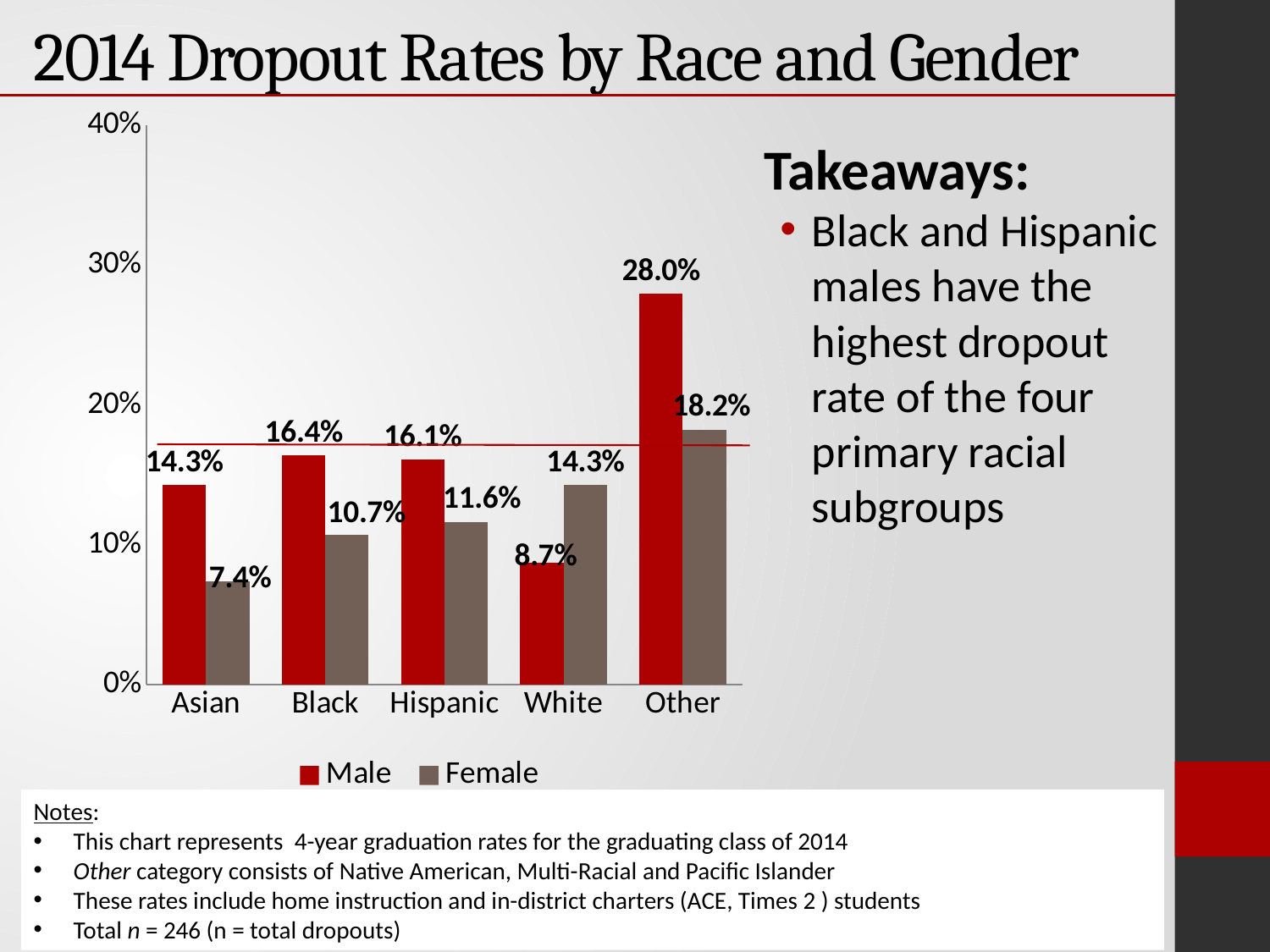
How many racial categories are shown on the x axis? 5 Is the Male dropout rate for the Other category greater or less than 20%? greater Which category has the highest Male dropout rate? Other What is the difference between the Male and Female dropout rates for Hispanic students? 4.5% What is the Male dropout rate for the Other category? 28.0% Which is larger for White students, the Male or the Female dropout rate? Female What is the Male dropout rate for Black students? 16.4% What kind of chart is shown on the slide? Bar chart What is the Female dropout rate for Asian students? 7.4% How many series does the legend list? 2 What is the Female dropout rate for White students? 14.3% Which category has the lowest Female dropout rate? Asian